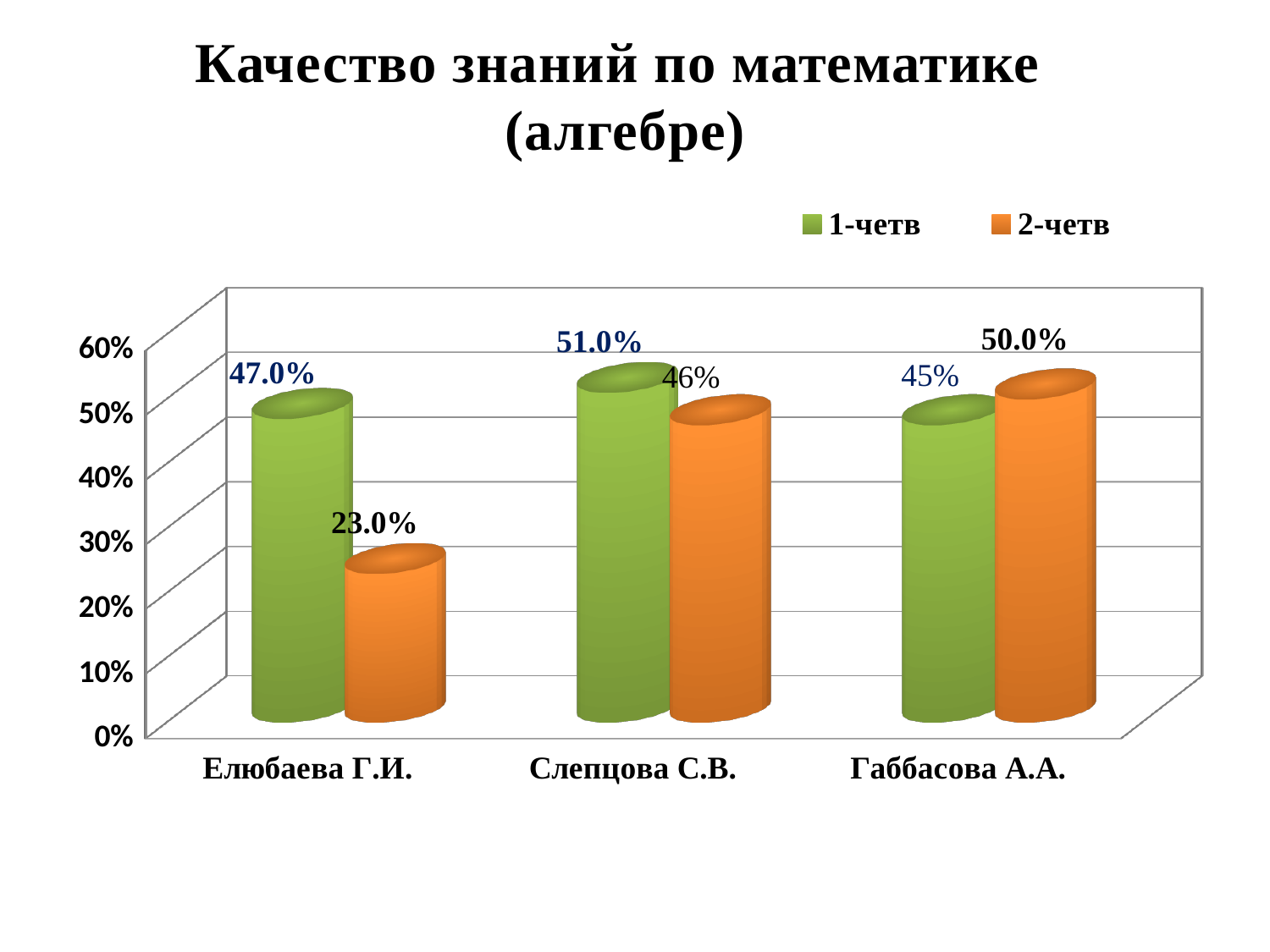
How many series does the legend list? 2 What is the value for Елюбаева Г.И. in the 1-четв series? 47.0% For Габбасова А.А., which series has the larger value, 1-четв or 2-четв? 2-четв Which category has the lowest value in the 2-четв series? Елюбаева Г.И. Is the 2-четв value for Елюбаева Г.И. greater or less than 30%? less Which category has the highest value in the 1-четв series? Слепцова С.В. What is the difference between the 1-четв and 2-четв values for Елюбаева Г.И.? 24.0% What is the value for Габбасова А.А. in the 2-четв series? 50.0% How many categories are shown on the x axis? 3 What kind of chart is shown on the slide? bar chart What is the value for Елюбаева Г.И. in the 2-четв series? 23.0% What is the value for Слепцова С.В. in the 1-четв series? 51.0%